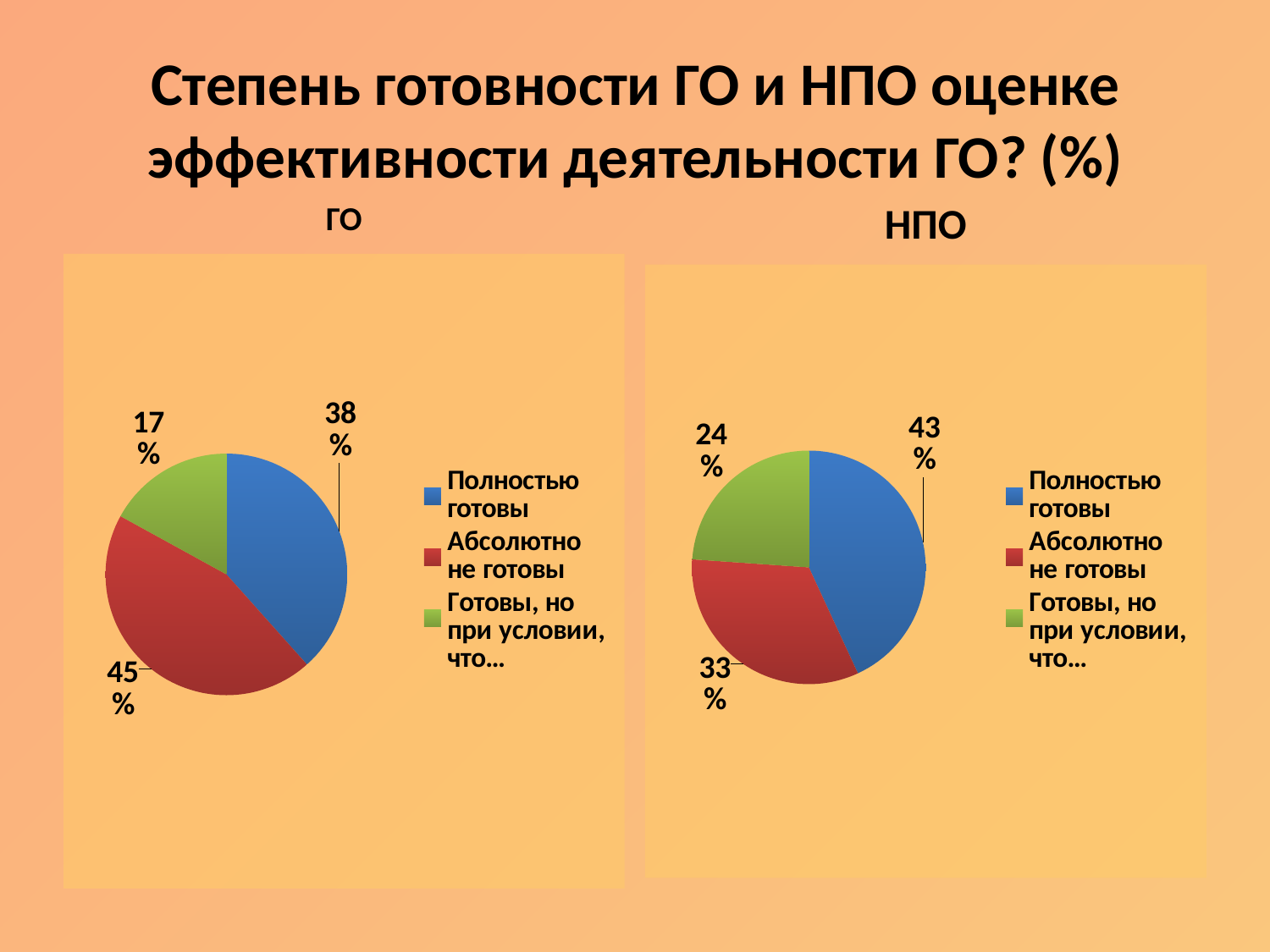
In the НПО chart, what share is labelled for "Абсолютно не готовы"? 33% What type of chart is used for the ГО data? Pie chart In the НПО chart, what share is labelled for "Готовы, но при условии, что…"? 24% How many categories does the legend of the НПО chart list? 3 In the ГО chart, which category has the largest slice? Абсолютно не готовы In the ГО chart, what is the difference between the "Абсолютно не готовы" and "Полностью готовы" shares? 7% In the НПО chart, which category has the smallest slice? Готовы, но при условии, что… In the ГО chart, what share is labelled for "Абсолютно не готовы"? 45% Which chart shows a larger share for "Полностью готовы", ГО or НПО? НПО In the ГО chart, what share is labelled for "Полностью готовы"? 38% In the ГО chart, what share is labelled for "Готовы, но при условии, что…"? 17% In the НПО chart, what share is labelled for "Полностью готовы"? 43%